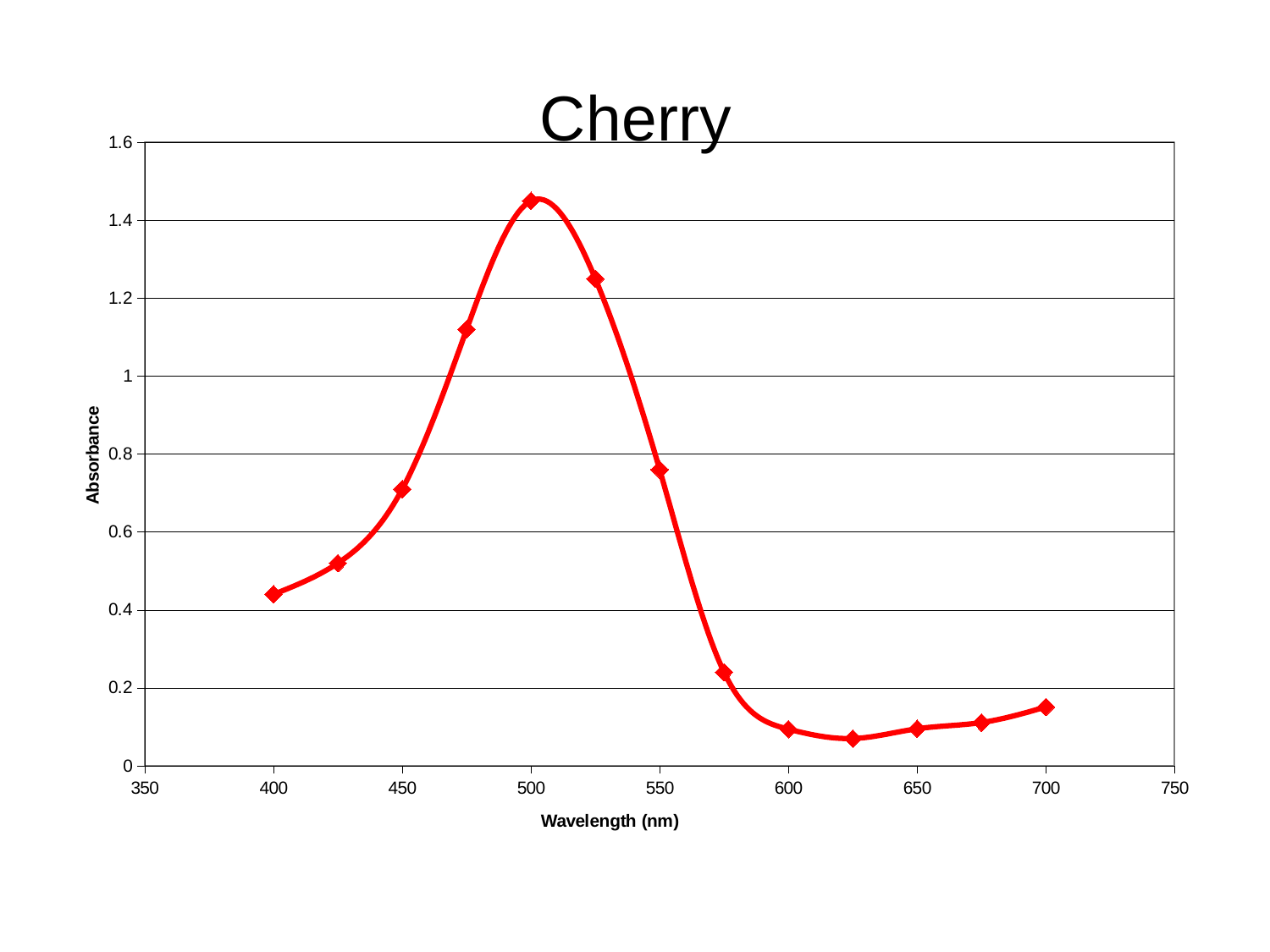
Is the absorbance at 475 nm greater or less than 1? greater Does the absorbance rise or fall as the wavelength increases from 400 nm to 500 nm? rise Is the absorbance at 500 nm greater or less than 1.4? greater What kind of chart is shown on the slide? Line chart What is the title of the chart? Cherry What is the label of the x axis? Wavelength (nm) Which has the higher absorbance, 400 nm or 700 nm? 400 nm Is the absorbance at 575 nm greater or less than 0.2? greater At which wavelength is the absorbance highest? 500 Which has the higher absorbance, 475 nm or 525 nm? 525 nm How many data points are plotted on the chart? 13